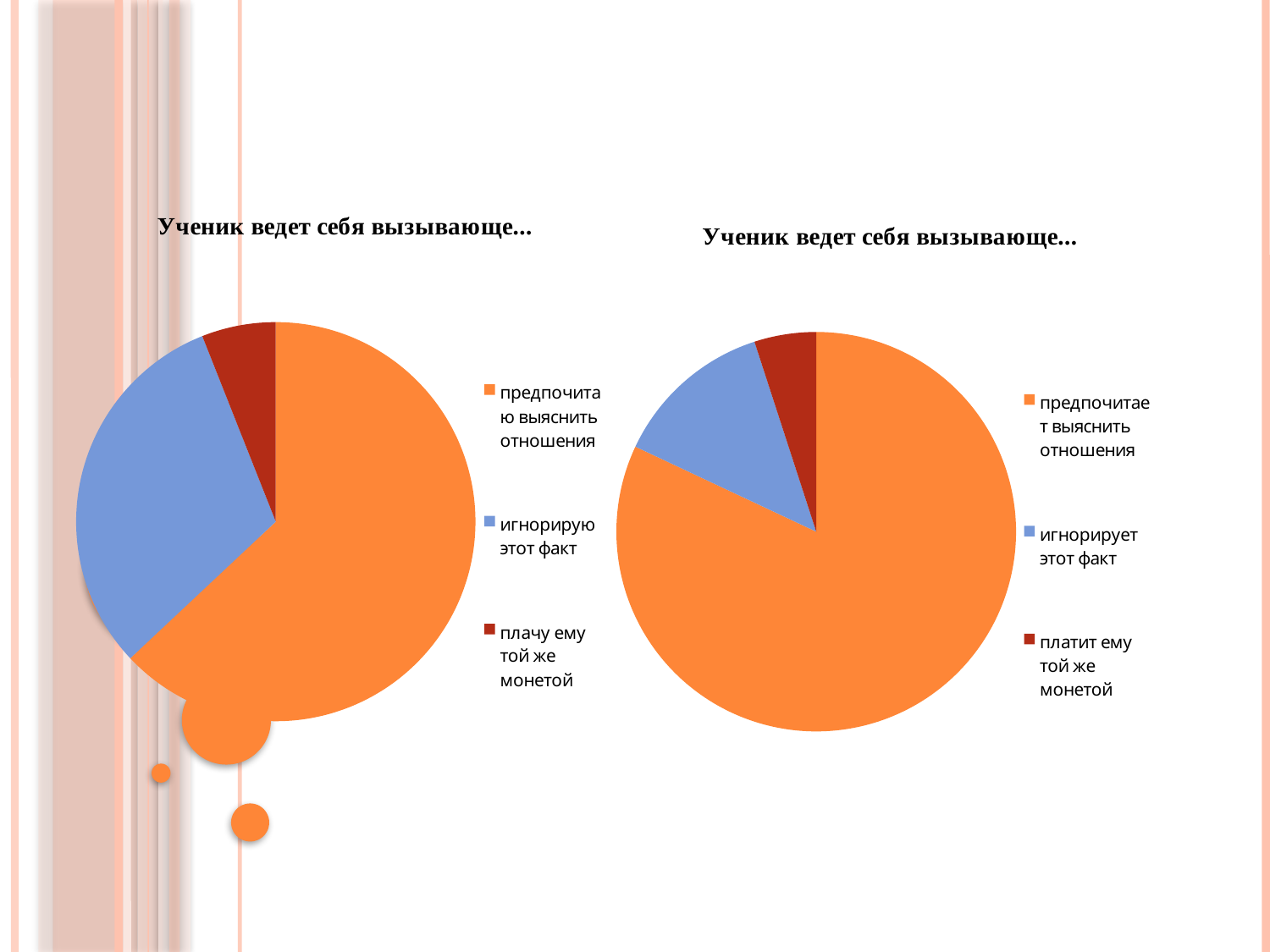
In the left pie chart, which category has the largest slice? предпочитаю выяснить отношения In the right pie chart, which category has the largest slice? предпочитает выяснить отношения In the right pie chart, what colour is the slice for "игнорирует этот факт"? blue How many slices does the right pie chart have? 3 In the left pie chart, which category has the smallest slice? плачу ему той же монетой In the left pie chart, which slice is larger: "игнорирую этот факт" or "плачу ему той же монетой"? игнорирую этот факт In the right pie chart, which category has the smallest slice? платит ему той же монетой What is the title of the left chart? Ученик ведет себя вызывающе... What kind of chart is the right chart on the slide? pie chart How many slices does the left pie chart have? 3 What kind of chart is the left chart on the slide? pie chart In the right pie chart, which slice is larger: "игнорирует этот факт" or "платит ему той же монетой"? игнорирует этот факт